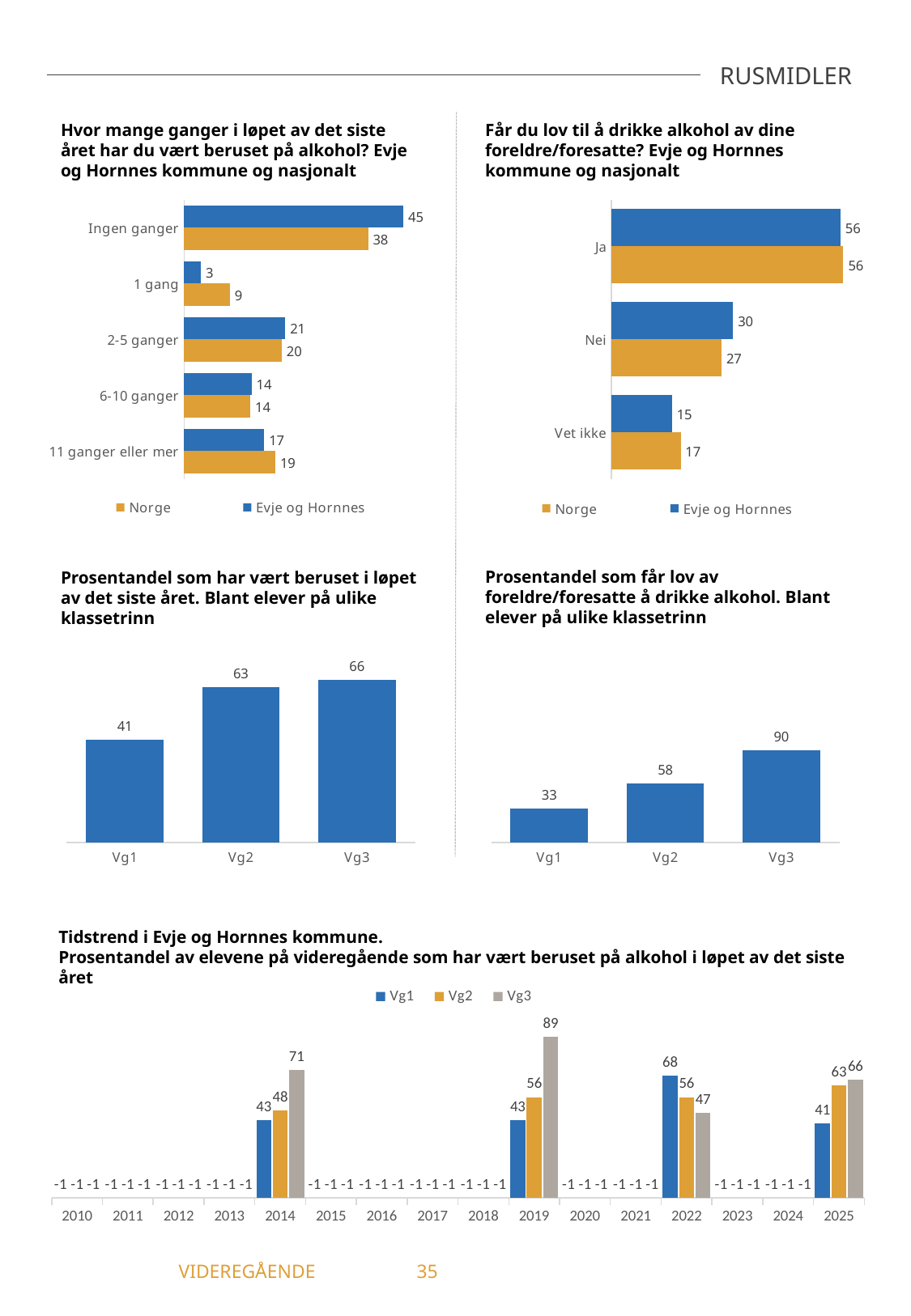
In the bottom chart (Tidstrend i Evje og Hornnes kommune), what is the value for Vg3 in 2019? 89 In the middle-right chart (Prosentandel som får lov av foreldre ...), what is the difference between Vg3 and Vg1? 57 In the top-left chart (Hvor mange ganger ... beruset på alkohol), what is the difference between the Norge and Evje og Hornnes values for '1 gang'? 6 In the top-right chart (Får du lov til å drikke alkohol ...), which category has the highest value for Evje og Hornnes? Ja In the middle-left chart (Prosentandel som har vært beruset ...), do the values rise or fall from Vg1 to Vg3? rise In the top-left chart (Hvor mange ganger ... beruset på alkohol), what is the value for Evje og Hornnes for 'Ingen ganger'? 45 In the top-right chart (Får du lov til å drikke alkohol ...), how many series does the legend list? 2 In the bottom chart (Tidstrend i Evje og Hornnes kommune), which is larger in 2022: Vg1 or Vg3? Vg1 In the middle-right chart (Prosentandel som får lov av foreldre ...), which class level has the lowest value? Vg1 In the middle-left chart (Prosentandel som har vært beruset ...), what is the value for Vg2? 63 In the top-left chart (Hvor mange ganger ... beruset på alkohol), how many categories are shown? 5 In the top-right chart (Får du lov til å drikke alkohol ...), what is the value for Norge for 'Nei'? 27